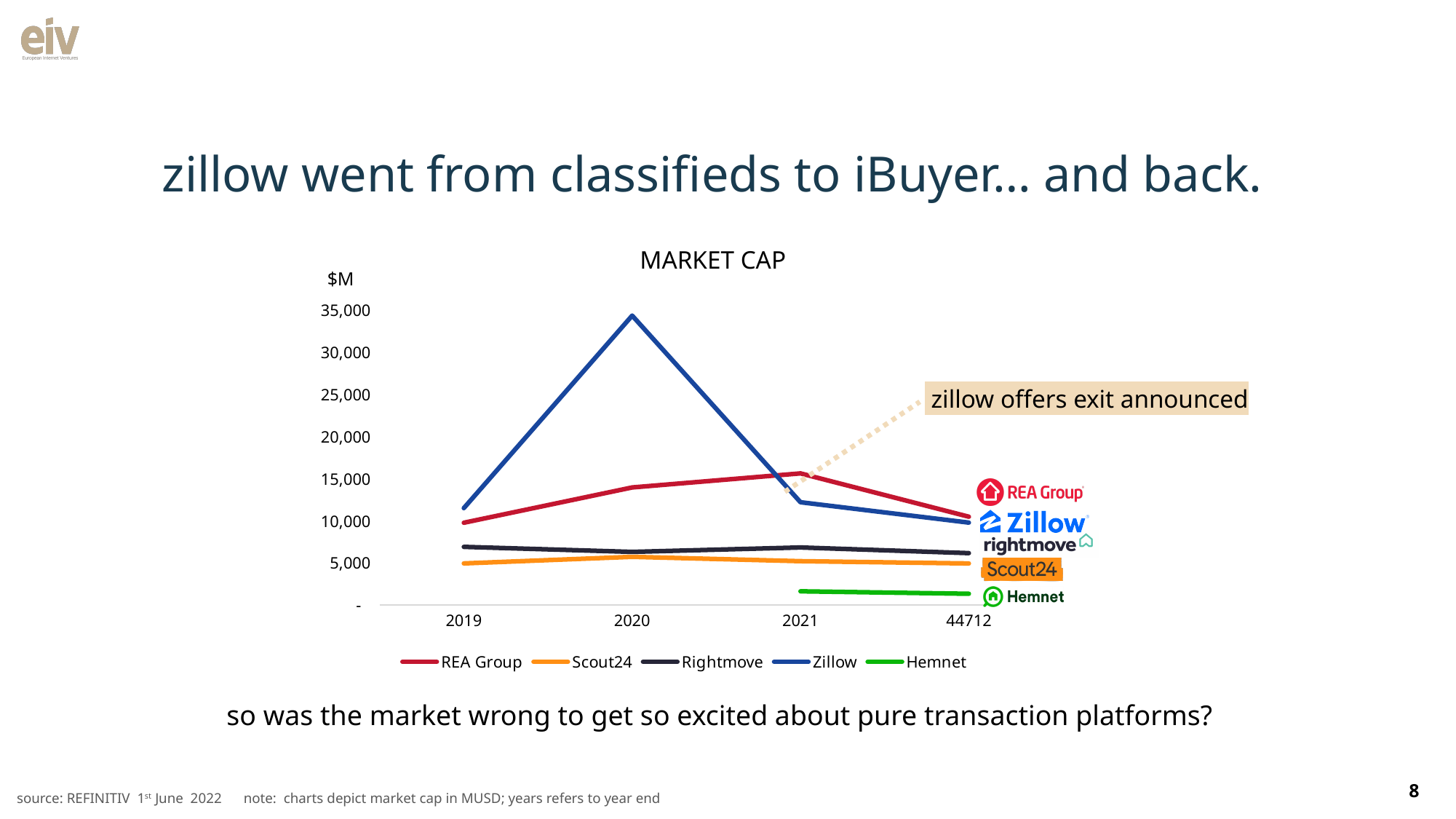
What kind of chart is shown on the slide? line chart Is the value for Zillow in 2020 greater or less than 30,000? greater Which company has the lowest market cap in 2021? Hemnet Is the value for Rightmove in 2019 greater or less than 10,000? less How many points are shown on the x axis of the MARKET CAP chart? 4 How many series does the legend of the MARKET CAP chart list? 5 What is the title of the chart? MARKET CAP Is the value for Hemnet in 2021 greater or less than 5,000? less Which company has the highest market cap in 2020? Zillow Does Zillow's market cap rise or fall from 2020 to 2021? fall Does REA Group's market cap rise or fall from 2019 to 2021? rise Which is larger in 2021, the market cap of REA Group or Zillow? REA Group